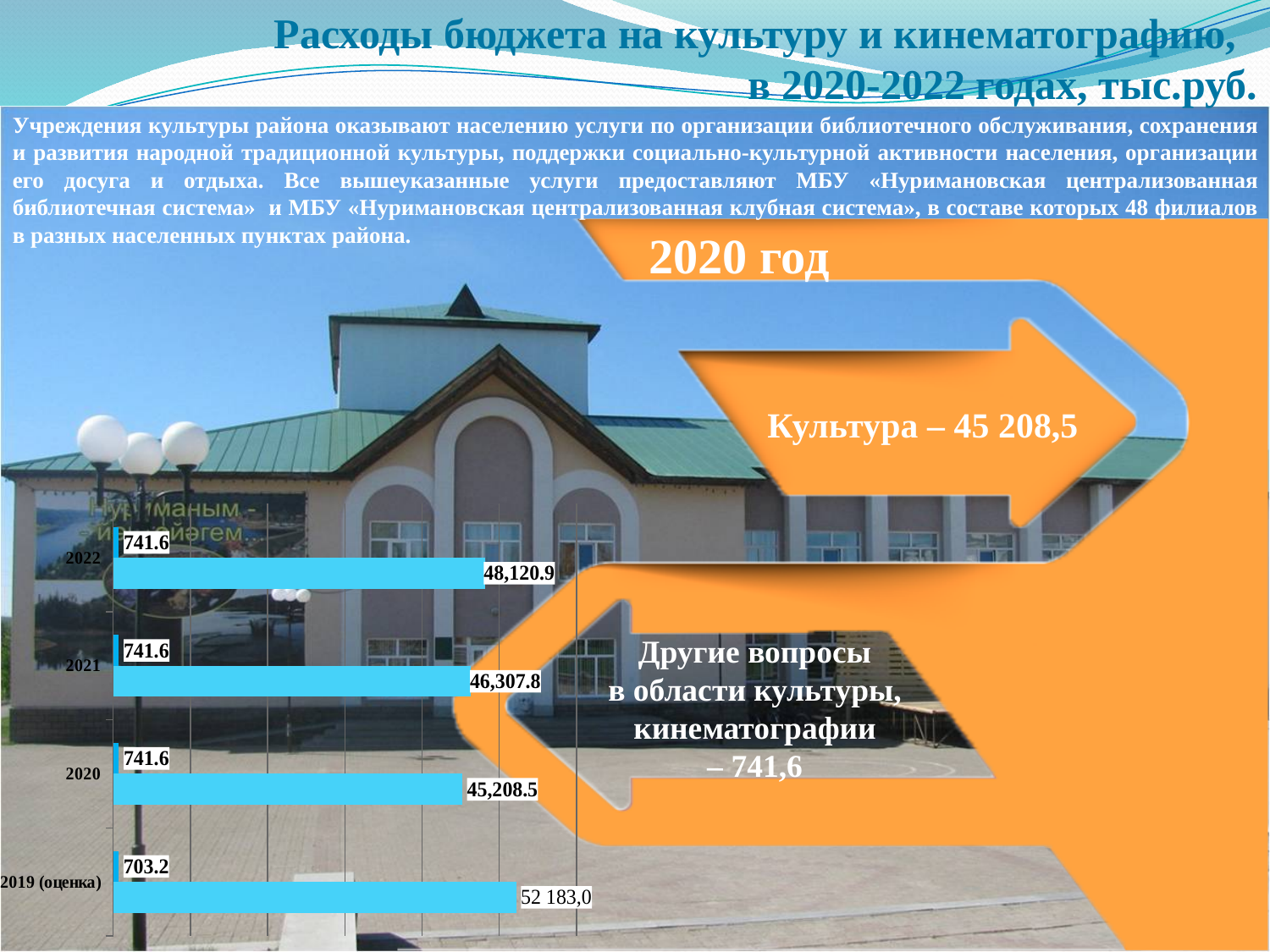
What is the value of the longer bar for 2021? 46,307.8 Which year has the lowest value for the longer bar? 2020 What is the difference between the longer-bar values for 2022 and 2021? 1,813.1 What type of chart is shown on the slide? Bar chart What is the difference between the shorter-bar values for 2022 and 2019 (оценка)? 38.4 Which year has the highest value for the longer bar? 2019 (оценка) How many year categories are shown in the chart? 4 What is the value of the shorter bar for 2019 (оценка)? 703.2 Which is larger, the longer-bar value for 2022 or for 2021? 2022 What is the value of the longer bar for 2019 (оценка)? 52 183,0 What is the value of the longer bar for 2022? 48,120.9 What is the value of the longer bar for 2020? 45,208.5